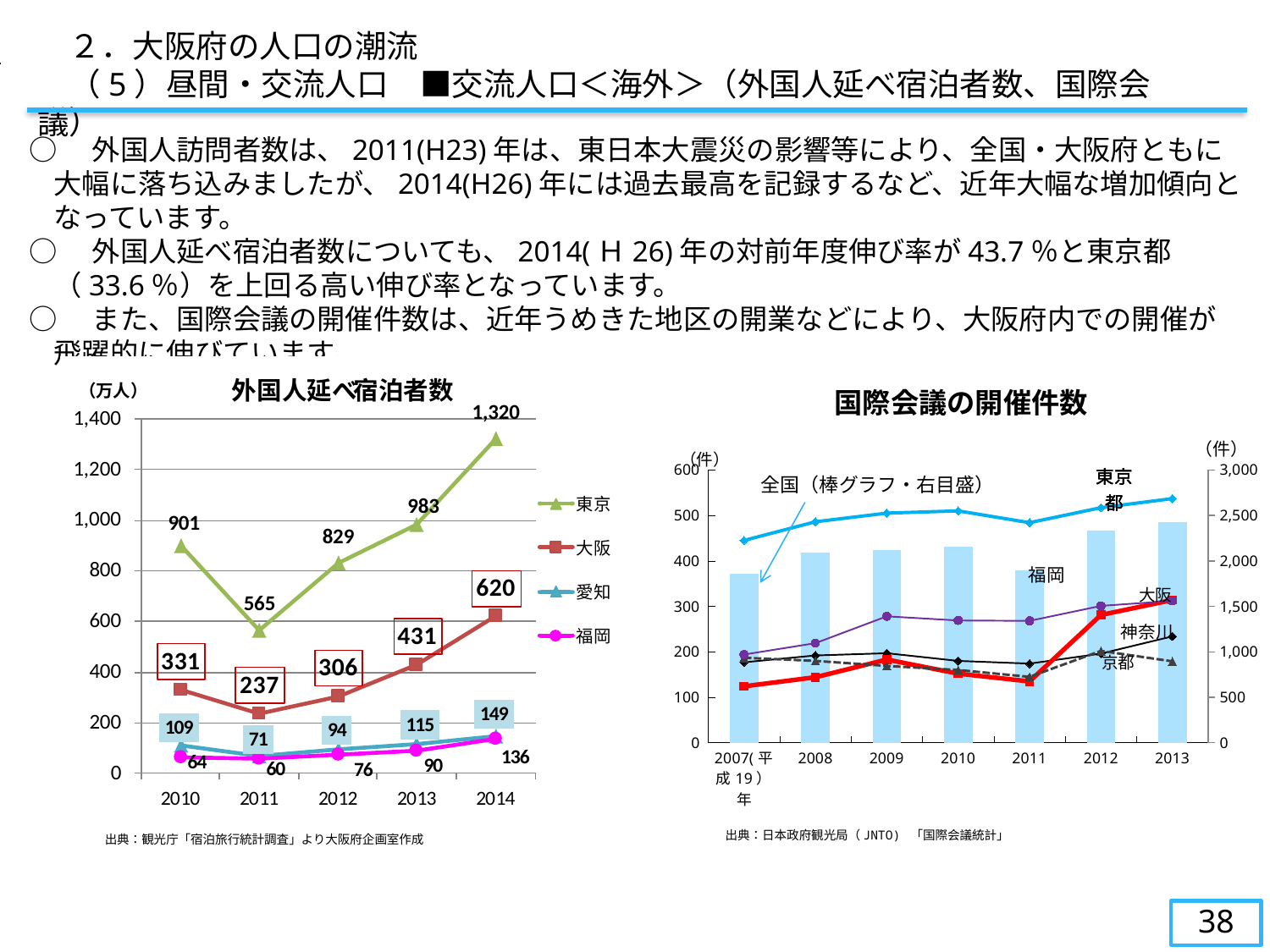
In the 外国人延べ宿泊者数 chart, what is the value for 愛知 in 2013? 115 In the 外国人延べ宿泊者数 chart, what is the value for 福岡 in 2010? 64 In the 外国人延べ宿泊者数 chart, what is the value for 大阪 in 2011? 237 In the 外国人延べ宿泊者数 chart, which series has the highest value in 2014? 東京 In the 外国人延べ宿泊者数 chart, what is the value for 東京 in 2014? 1,320 What kind of chart is the 外国人延べ宿泊者数 chart? Line chart In the 外国人延べ宿泊者数 chart, what is the difference between the 大阪 values for 2014 and 2013? 189 How many years are shown on the x axis of the 外国人延べ宿泊者数 chart? 5 In the 国際会議の開催件数 chart, which is larger in 2011, 福岡 or 大阪? 福岡 In the 外国人延べ宿泊者数 chart, in which year is the 東京 value lowest? 2011 How many series does the legend of the 外国人延べ宿泊者数 chart list? 4 In the 国際会議の開催件数 chart, is the value for 東京都 in 2013 greater or less than 500? greater